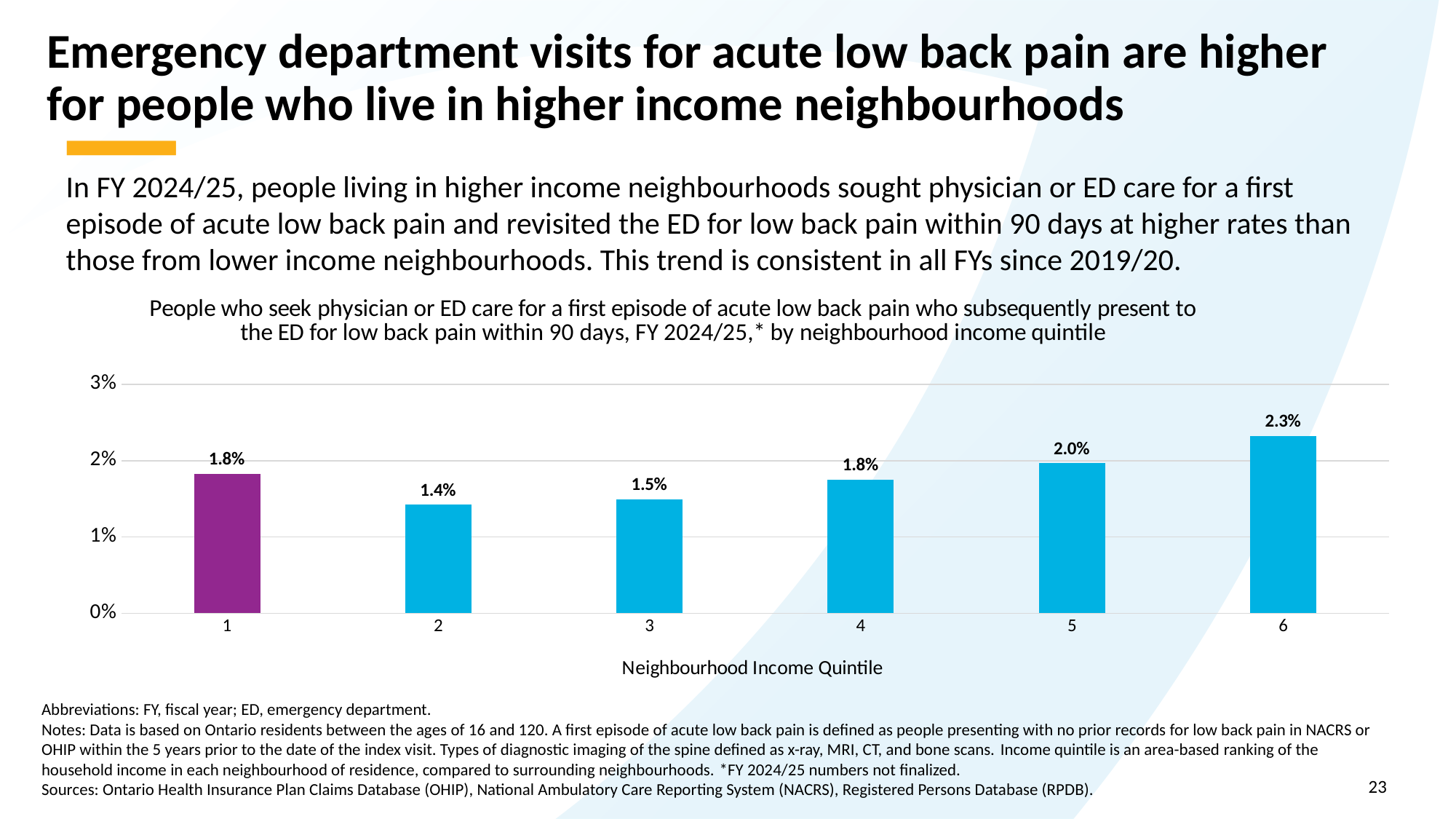
What is the value for neighbourhood income quintile 2? 1.4% How many neighbourhood income quintiles are shown on the x axis? 6 Which neighbourhood income quintile has the lowest value? 2 What is the difference between the values for quintile 6 and quintile 2? 0.9% Is the value for quintile 6 greater or less than 2%? greater Which is larger, the value for quintile 5 or the value for quintile 3? Quintile 5 What is the value for neighbourhood income quintile 5? 2.0% What is the value for neighbourhood income quintile 6? 2.3% What kind of chart is shown on the slide? Bar chart Which neighbourhood income quintile has the highest value? 6 What colour is the bar for neighbourhood income quintile 1? Purple What is the value for neighbourhood income quintile 3? 1.5%